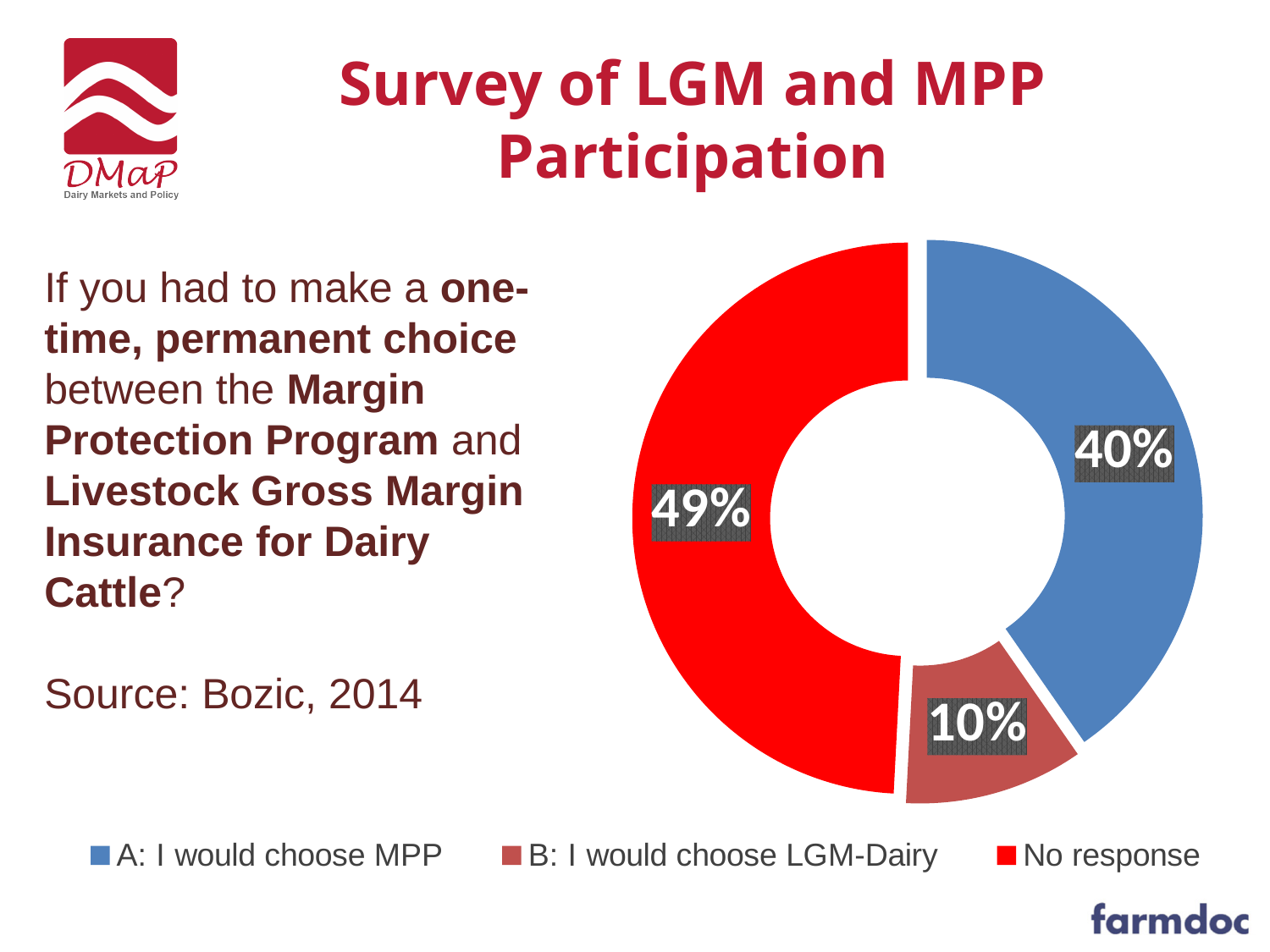
How many categories does the pie chart show? 3 What is the difference in percentage points between the share choosing MPP and the share choosing LGM-Dairy? 30 What share of respondents said they would choose MPP? 40% Which category has the largest share of the pie? No response What kind of chart is shown on the slide? Pie chart (doughnut) Which is larger: the share choosing MPP or the share choosing LGM-Dairy? A: I would choose MPP What share of respondents gave no response? 49% What colour represents the No response category? Red What share of respondents said they would choose LGM-Dairy? 10% What is the source cited for the survey data? Bozic, 2014 Which category has the smallest share of the pie? B: I would choose LGM-Dairy What is the difference in percentage points between the No response share and the share choosing MPP? 9